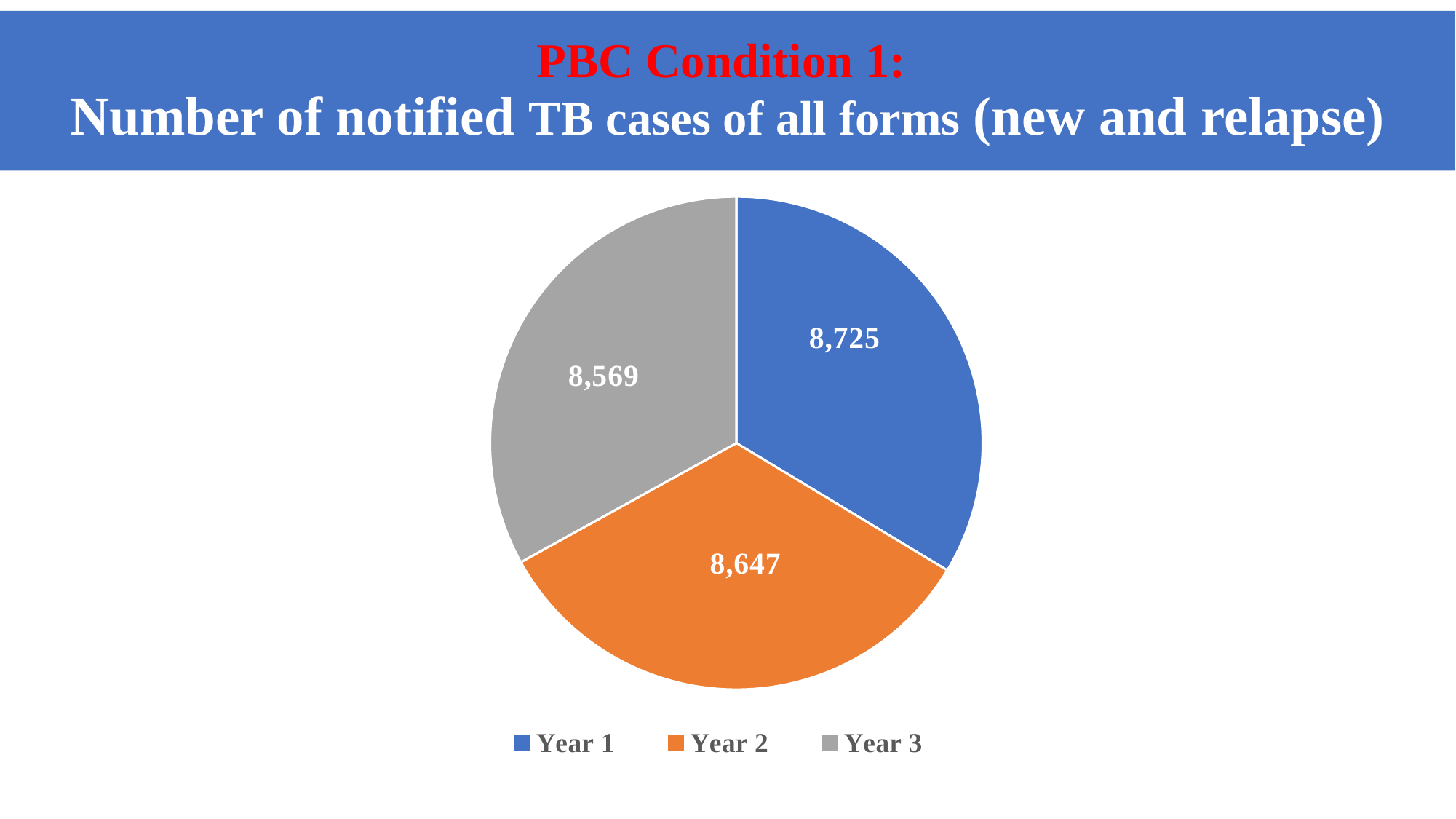
Which year has the highest number of notified TB cases? Year 1 What is the number of notified TB cases for Year 1? 8,725 What is the difference between the Year 1 and Year 3 values? 156 What is the difference between the Year 1 and Year 2 values? 78 What colour is the Year 2 slice in the pie chart? Orange Which is larger, the value for Year 2 or the value for Year 3? Year 2 What is the number of notified TB cases for Year 2? 8,647 What is the number of notified TB cases for Year 3? 8,569 What kind of chart is shown on the slide? Pie chart How many slices does the pie chart have? 3 Do the values rise or fall from Year 1 to Year 3? Fall Which year has the lowest number of notified TB cases? Year 3